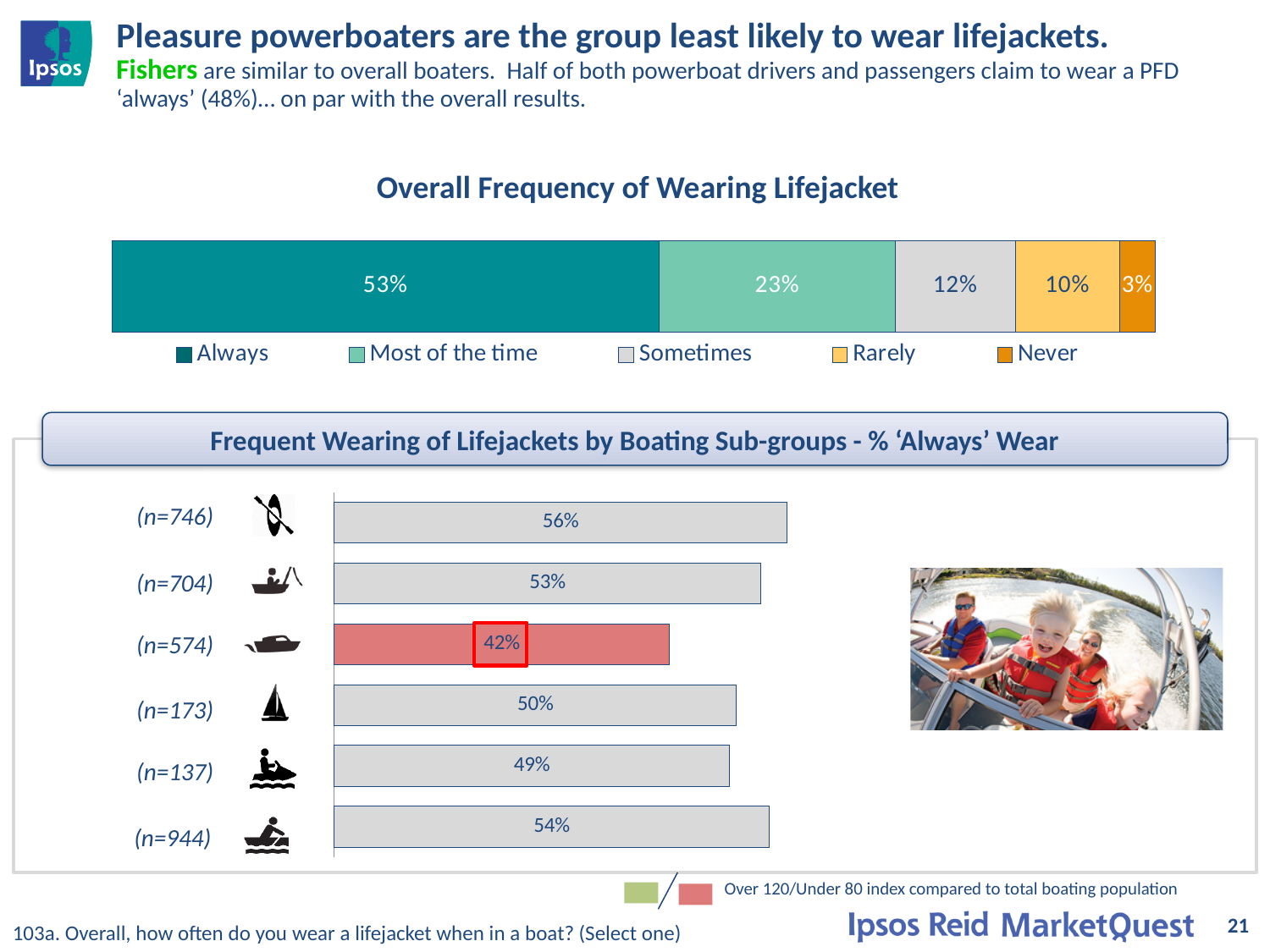
In the 'Frequent Wearing of Lifejackets by Boating Sub-groups' chart, what is the value for the group with n=944? 54% In the 'Frequent Wearing of Lifejackets by Boating Sub-groups' chart, how many bars are plotted? 6 In the 'Overall Frequency of Wearing Lifejacket' chart, what percentage of boaters say they 'Always' wear a lifejacket? 53% In the 'Overall Frequency of Wearing Lifejacket' chart, what percentage is shown for 'Never'? 3% In the 'Frequent Wearing of Lifejackets by Boating Sub-groups' chart, what is the value for the group with n=574? 42% In the 'Overall Frequency of Wearing Lifejacket' chart, how many categories does the legend list? 5 In the 'Frequent Wearing of Lifejackets by Boating Sub-groups' chart, which group has the highest '% Always' value? n=746 What kind of chart is the 'Frequent Wearing of Lifejackets by Boating Sub-groups' chart? Bar chart In the 'Overall Frequency of Wearing Lifejacket' chart, what is the difference between the 'Sometimes' and 'Rarely' percentages? 2% In the 'Overall Frequency of Wearing Lifejacket' chart, what percentage is shown for 'Most of the time'? 23% In the 'Frequent Wearing of Lifejackets by Boating Sub-groups' chart, what is the difference between the values for the n=746 group and the n=574 group? 14% In the 'Overall Frequency of Wearing Lifejacket' chart, which category has the smallest share? Never